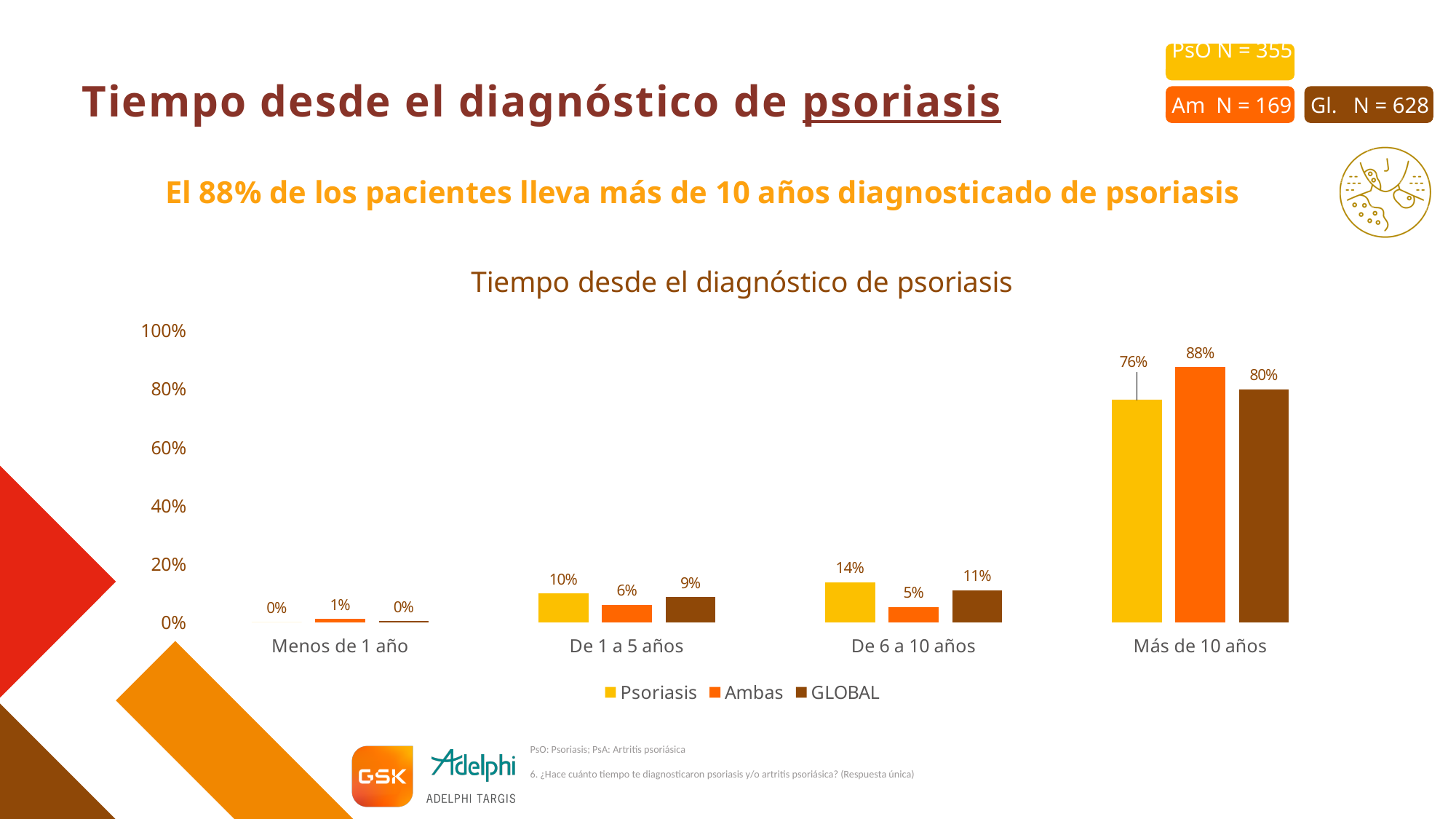
What is the GLOBAL value for 'De 1 a 5 años'? 9% What is the value for Psoriasis in the 'De 6 a 10 años' category? 14% How many series does the legend list? 3 Which is larger in the 'De 1 a 5 años' category: Psoriasis or Ambas? Psoriasis What is the value for Ambas in the 'Más de 10 años' category? 88% How many categories are shown on the x axis? 4 What is the difference between the Ambas and Psoriasis values for 'Más de 10 años'? 12% Which category has the highest GLOBAL value? Más de 10 años What is the title of the chart? Tiempo desde el diagnóstico de psoriasis What kind of chart is shown on the slide? Bar chart Which series has the lowest value in the 'De 6 a 10 años' category? Ambas Is the GLOBAL value for 'Más de 10 años' greater or less than 60%? greater